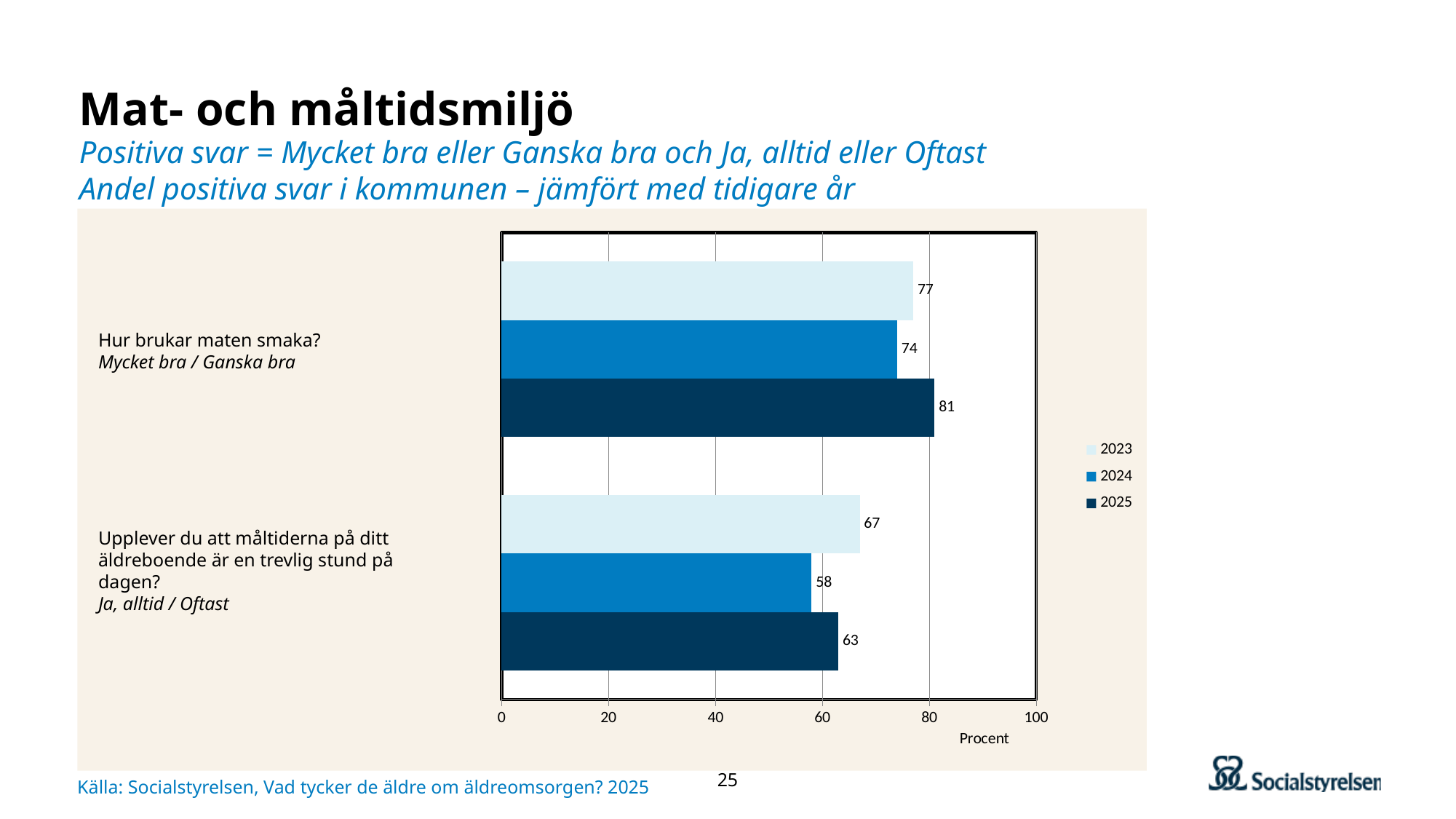
What is the 2024 value for "Upplever du att måltiderna på ditt äldreboende är en trevlig stund på dagen?"? 58 What is the difference between the 2025 and 2024 values for "Hur brukar maten smaka?"? 7 Is the 2025 value for "Upplever du att måltiderna på ditt äldreboende är en trevlig stund på dagen?" greater or less than 80? less Which year has the lowest value for "Upplever du att måltiderna på ditt äldreboende är en trevlig stund på dagen?"? 2024 Which year has the highest value for "Hur brukar maten smaka?"? 2025 How many series does the legend list? 3 What is the label on the horizontal axis of the chart? Procent What is the 2023 value for "Hur brukar maten smaka?"? 77 Which is larger: the 2023 value for "Hur brukar maten smaka?" or the 2023 value for "Upplever du att måltiderna på ditt äldreboende är en trevlig stund på dagen?"? Hur brukar maten smaka? What is the 2025 value for "Hur brukar maten smaka?"? 81 What is the difference between the 2023 and 2025 values for "Upplever du att måltiderna på ditt äldreboende är en trevlig stund på dagen?"? 4 What kind of chart is shown on the slide? bar chart